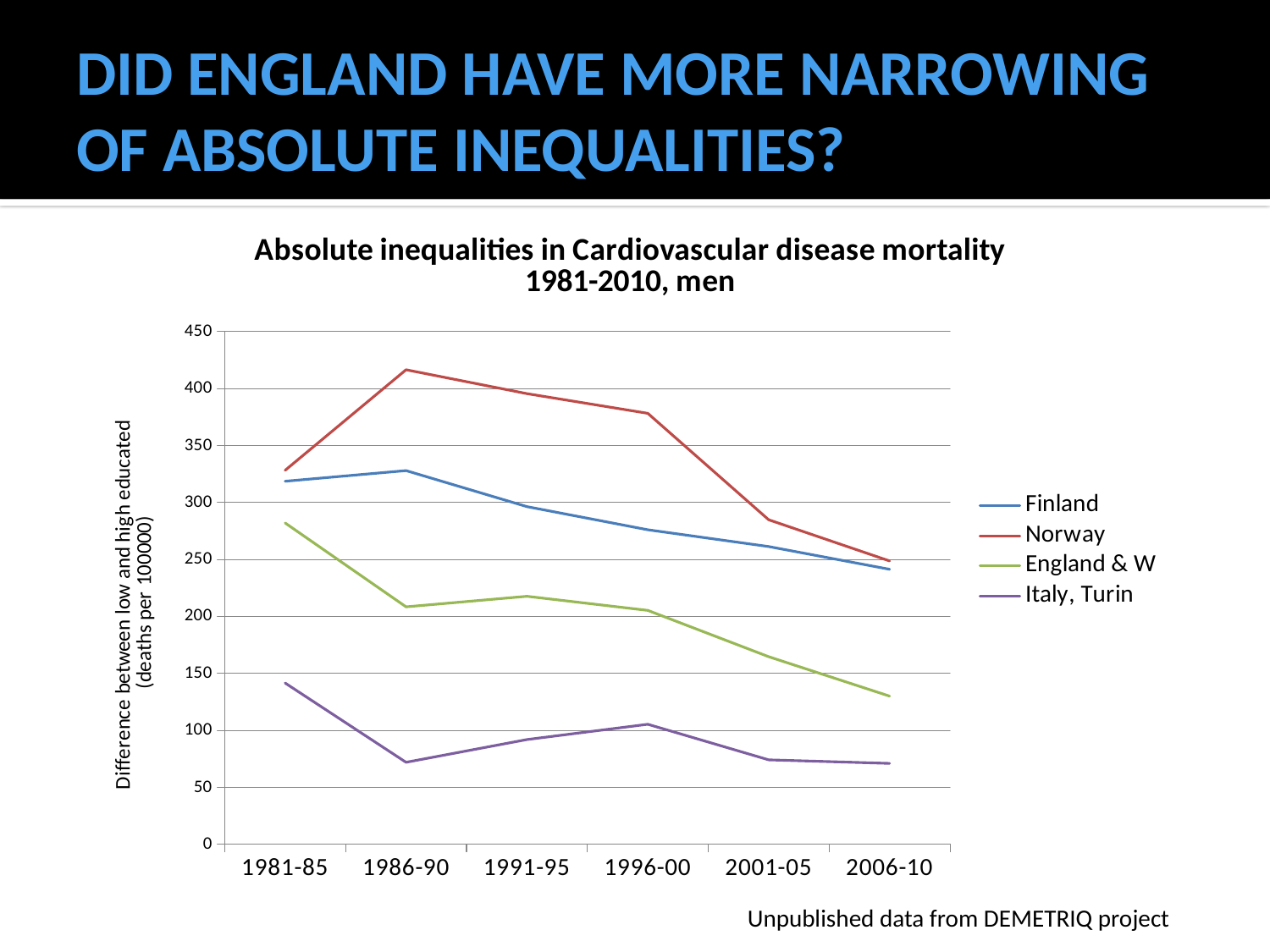
Is the value for England & W in 2006-10 greater or less than 150? less Does the England & W line rise or fall overall from 1981-85 to 2006-10? Fall Which series has the highest value in 1986-90? Norway Is the value for Norway in 1986-90 greater or less than 400? greater Is the value for Italy, Turin in 1986-90 greater or less than 100? less In 2006-10, which is larger: the value for England & W or the value for Italy, Turin? England & W Which series has the lowest value in 1981-85? Italy, Turin What is the title of the chart? Absolute inequalities in Cardiovascular disease mortality 1981-2010, men How many time periods are shown on the x axis? 6 What kind of chart is shown on the slide? Line chart How many series does the legend list? 4